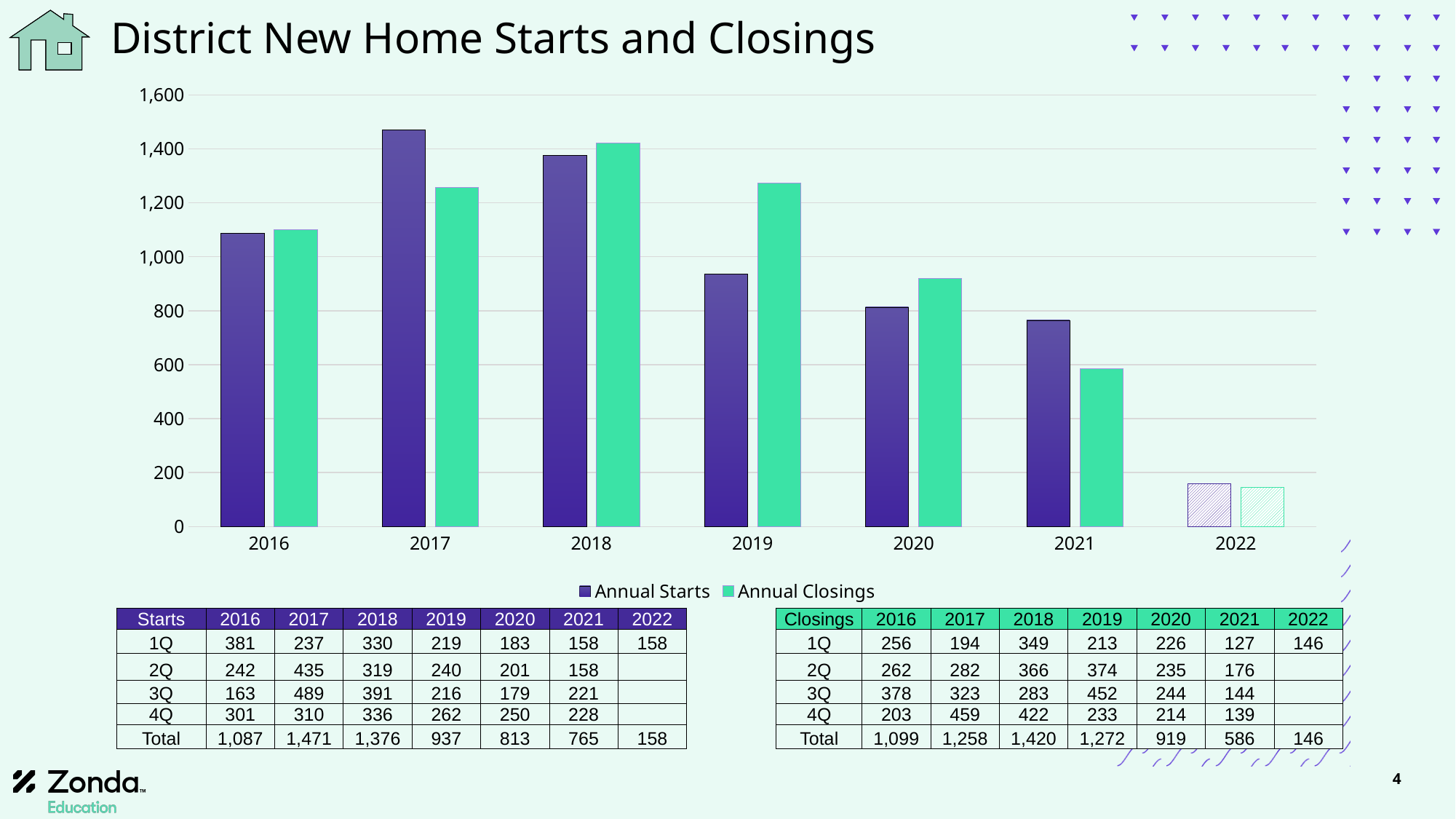
How many series does the chart legend list? 2 According to the Closings table, what is the total Annual Closings for 2020? 919 Do the Annual Starts values rise or fall from 2017 to 2022? fall Is the Annual Closings value for 2021 greater or less than 600? less Which year has the highest Annual Starts bar? 2017 According to the Starts table, what is the total Annual Starts for 2018? 1,376 Which year has the lowest Annual Closings bar? 2022 In 2019, which is larger, Annual Starts or Annual Closings? Annual Closings What kind of chart is shown on the slide? bar chart Is the Annual Starts value for 2017 greater or less than 1,400? greater How many years are shown along the x axis of the chart? 7 Using the totals in the tables, what is the difference between Annual Closings and Annual Starts in 2019? 335